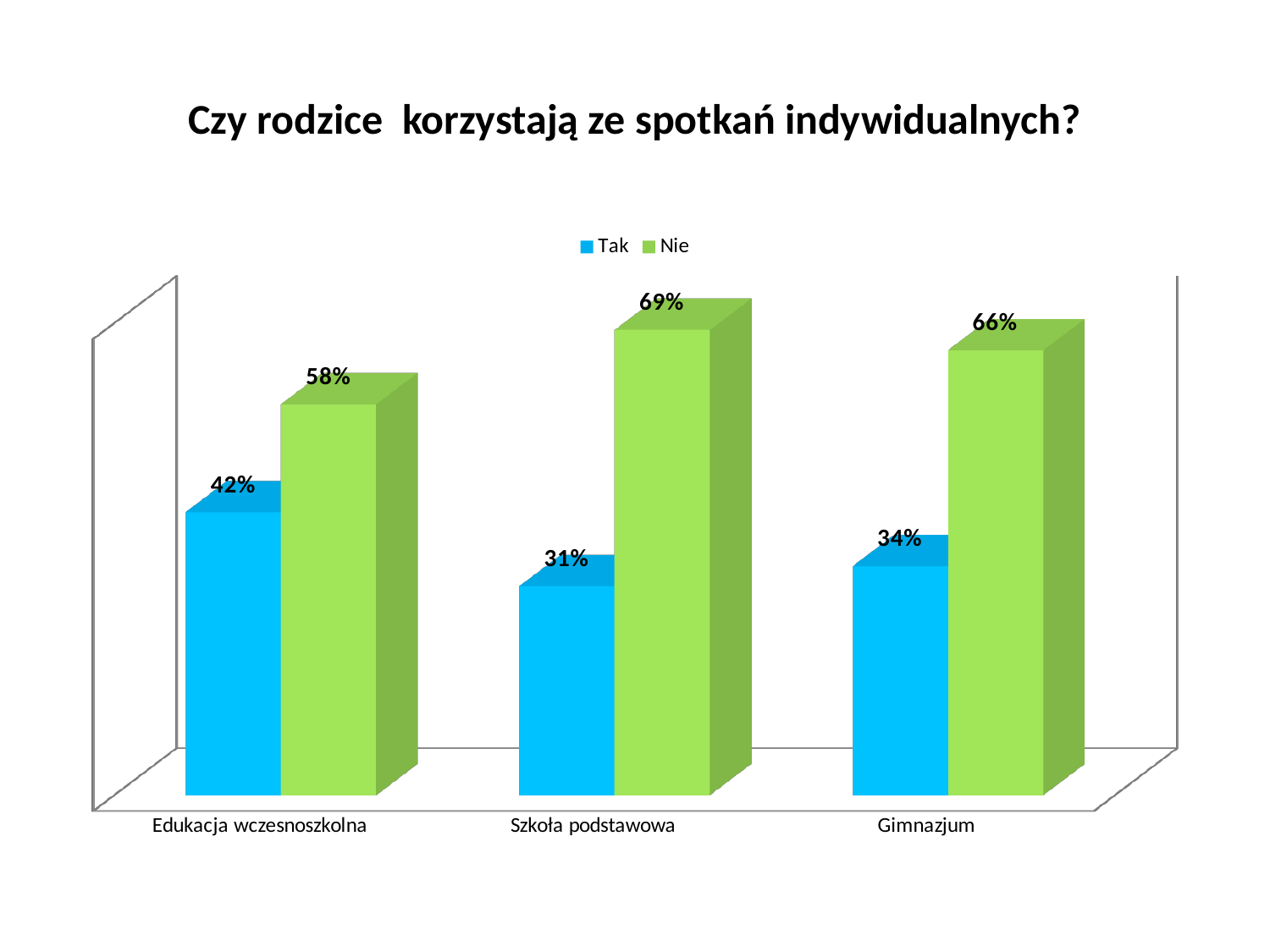
What is the difference between the "Nie" and "Tak" values in the Edukacja wczesnoszkolna category? 16% Which category has the highest value for "Nie"? Szkoła podstawowa What is the value for "Tak" in the Gimnazjum category? 34% What is the value for "Nie" in the Szkoła podstawowa category? 69% What kind of chart is shown on the slide? Bar chart Which category has the lowest value for "Tak"? Szkoła podstawowa How many series does the legend list? 2 What is the value for "Tak" in the Edukacja wczesnoszkolna category? 42% Which is larger in the Szkoła podstawowa category, "Tak" or "Nie"? Nie What is the value for "Nie" in the Gimnazjum category? 66% What is the title of the chart? Czy rodzice korzystają ze spotkań indywidualnych? How many categories are shown on the x axis? 3